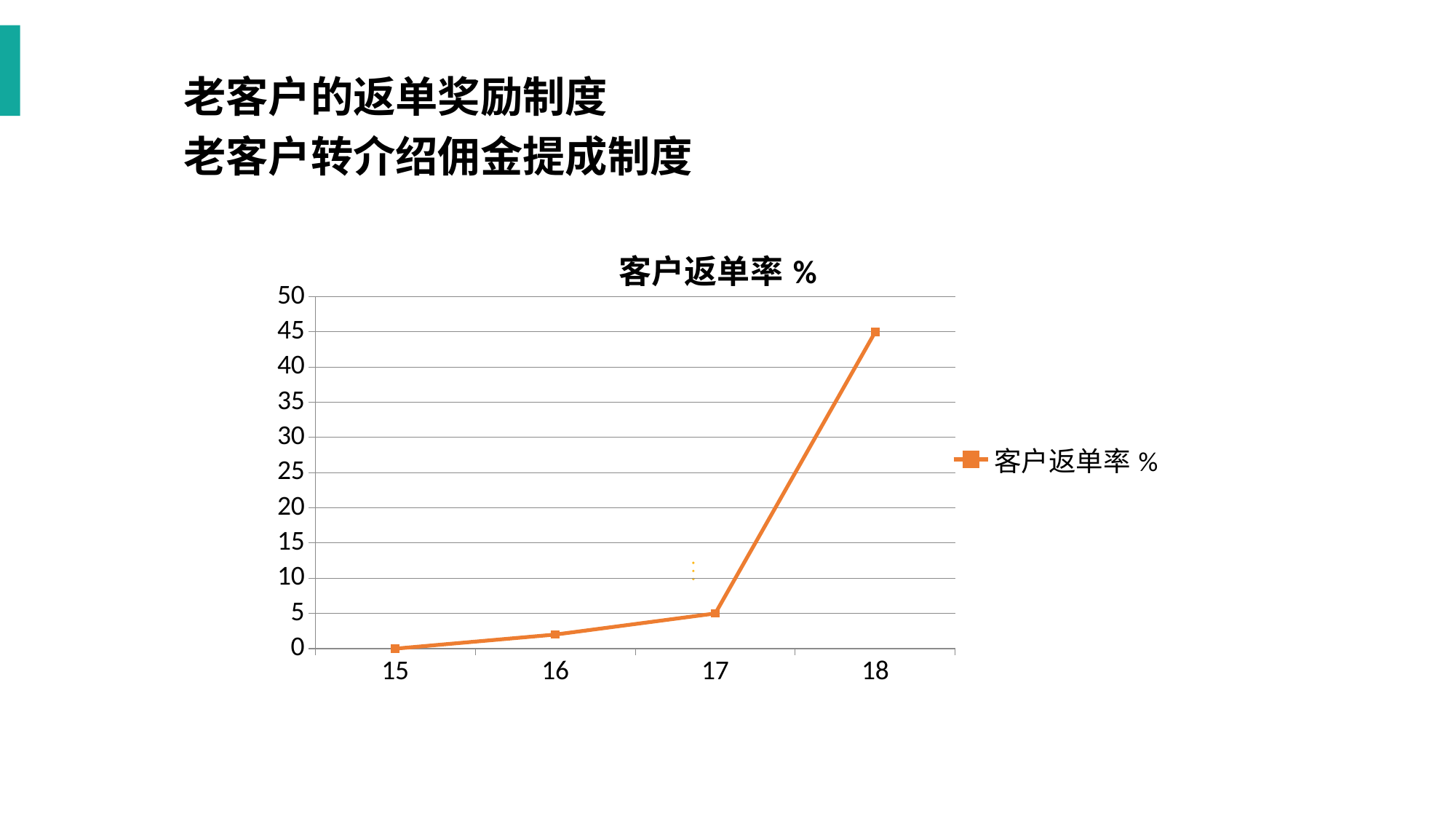
What kind of chart is shown on the slide? line chart How many data points are plotted on the line? 4 Do the 客户返单率 % values rise or fall from 15 to 18 along the x axis? rise What is the 客户返单率 % value at 17? 5 Is the 客户返单率 % value at 16 greater or less than 5? less What is the 客户返单率 % value at 15? 0 What is the 客户返单率 % value at 18? 45 How many series does the legend list? 1 What is the title of the chart? 客户返单率 % Which x-axis category has the highest 客户返单率 %? 18 Which x-axis category has the lowest 客户返单率 %? 15 What is the difference between the 客户返单率 % values at 18 and 17? 40